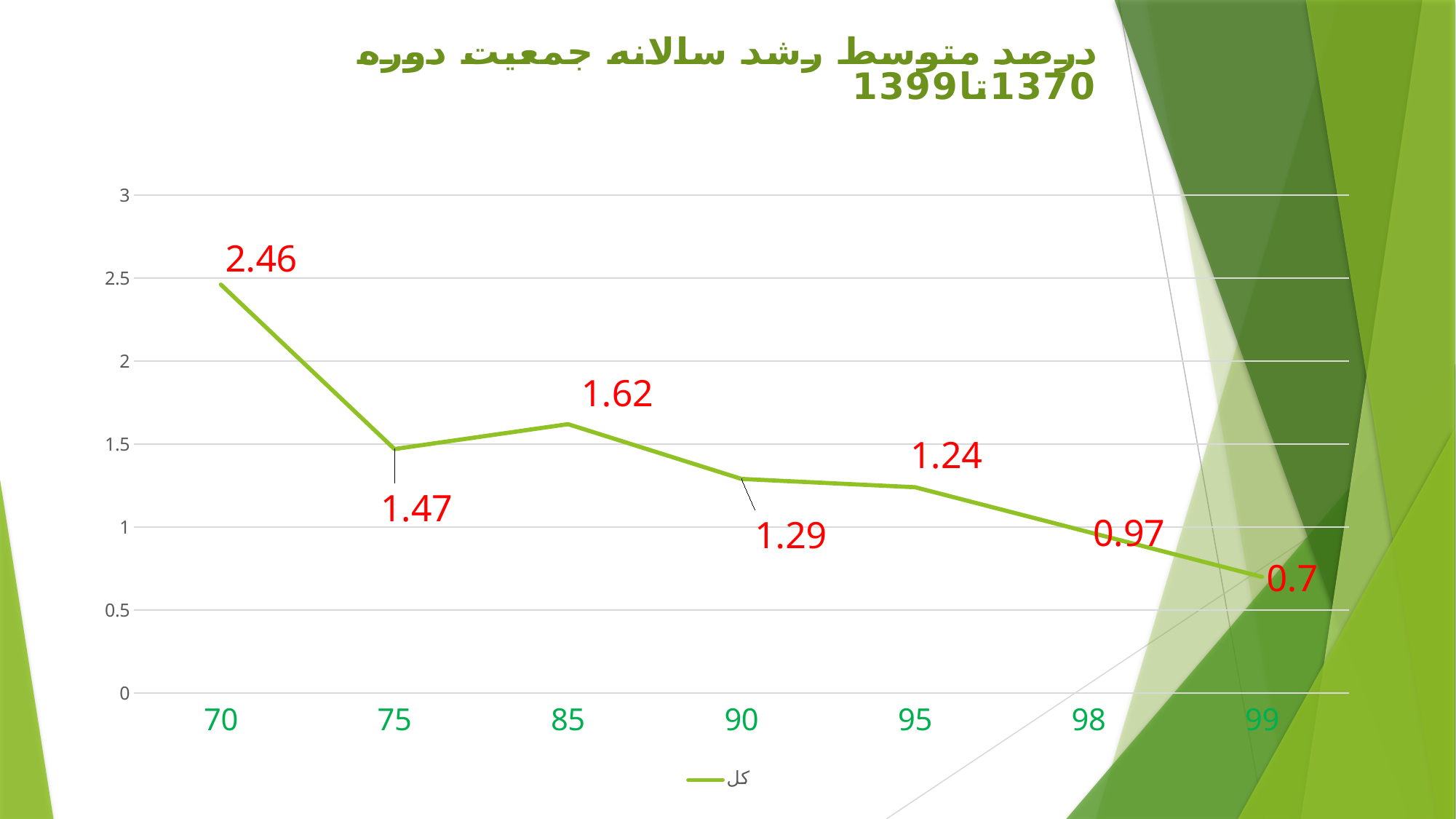
Which category has the lowest value? 99 Which is larger, the value for 75 or the value for 85? 85 Do the values generally rise or fall from 70 to 99? fall What is the value for 70? 2.46 What is the value for 85? 1.62 How many series does the legend list? 1 Which category has the highest value? 70 What is the difference between the values for 70 and 75? 0.99 How many points are plotted on the line? 7 What kind of chart is shown on the slide? line chart What is the value for 98? 0.97 What is the value for 99? 0.7